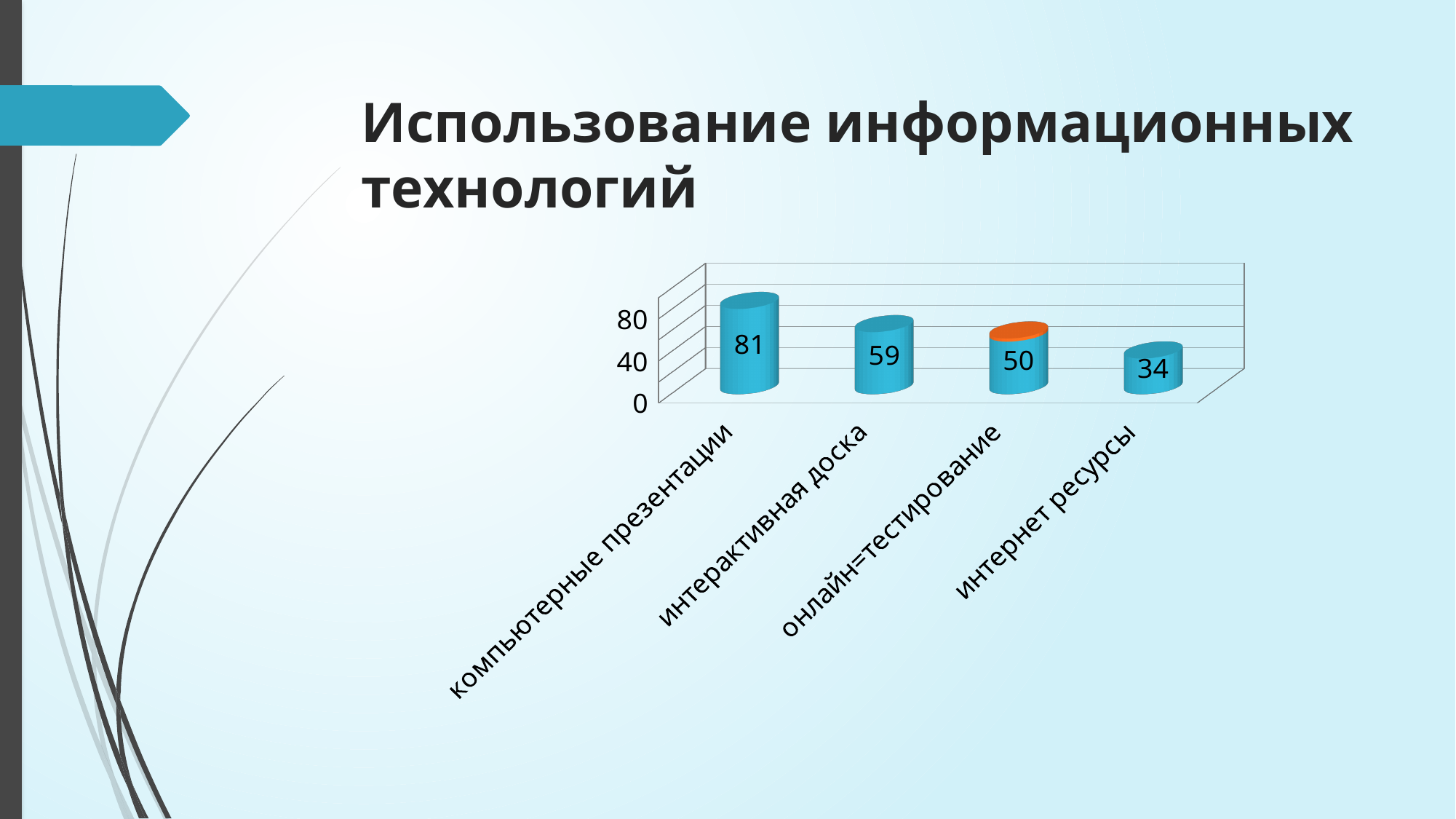
What kind of chart is shown on the slide? bar chart How many categories are shown in the chart? 4 What is the value for интерактивная доска? 59 What is the value for компьютерные презентации? 81 Which category has the highest value? компьютерные презентации What is the difference between the values for интерактивная доска and онлайн=тестирование? 9 What is the value for интернет ресурсы? 34 What is the value for онлайн=тестирование? 50 Which is larger, the value for интерактивная доска or the value for интернет ресурсы? интерактивная доска Do the values rise or fall from left to right along the x axis? fall Which category has the lowest value? интернет ресурсы What is the difference between the values for компьютерные презентации and интернет ресурсы? 47